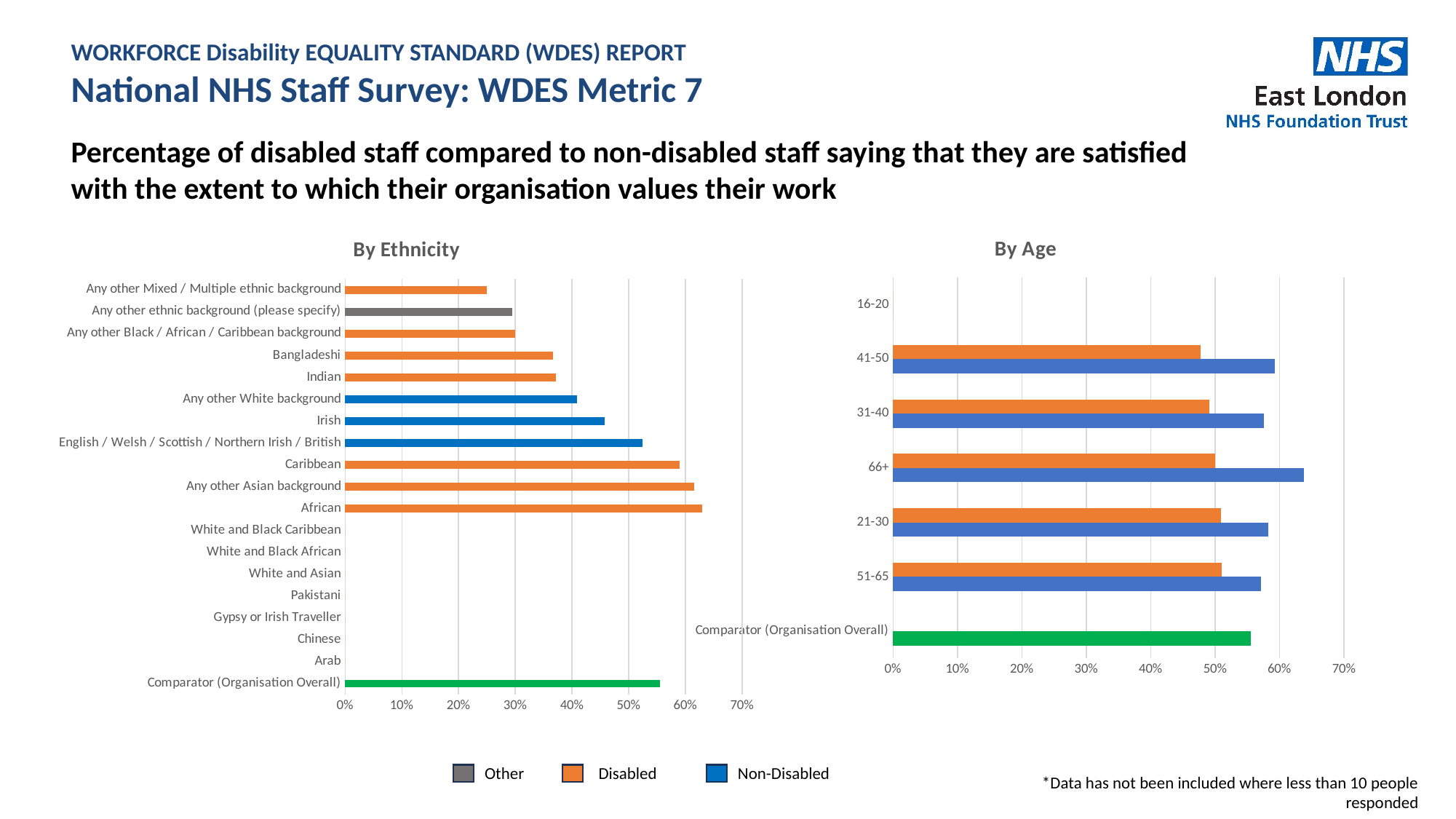
What kind of chart is the "By Ethnicity" chart? bar chart In the "By Age" chart, is the Disabled value for 41-50 greater or less than 50%? less In the "By Age" chart, which age group has the highest Non-Disabled value? 66+ In the "By Ethnicity" chart, is the value for Any other Mixed / Multiple ethnic background greater or less than 30%? less In the "By Ethnicity" chart, which is larger, the value for Irish or the value for Indian? Irish In the "By Age" chart, is the Non-Disabled value for 66+ greater or less than 60%? greater In the "By Age" chart, which is larger for 21-30, the Disabled value or the Non-Disabled value? Non-Disabled How many series does the legend list? 3 In the "By Ethnicity" chart, which category with a plotted bar has the lowest value? Any other Mixed / Multiple ethnic background In the "By Age" chart, which age group has no bars plotted? 16-20